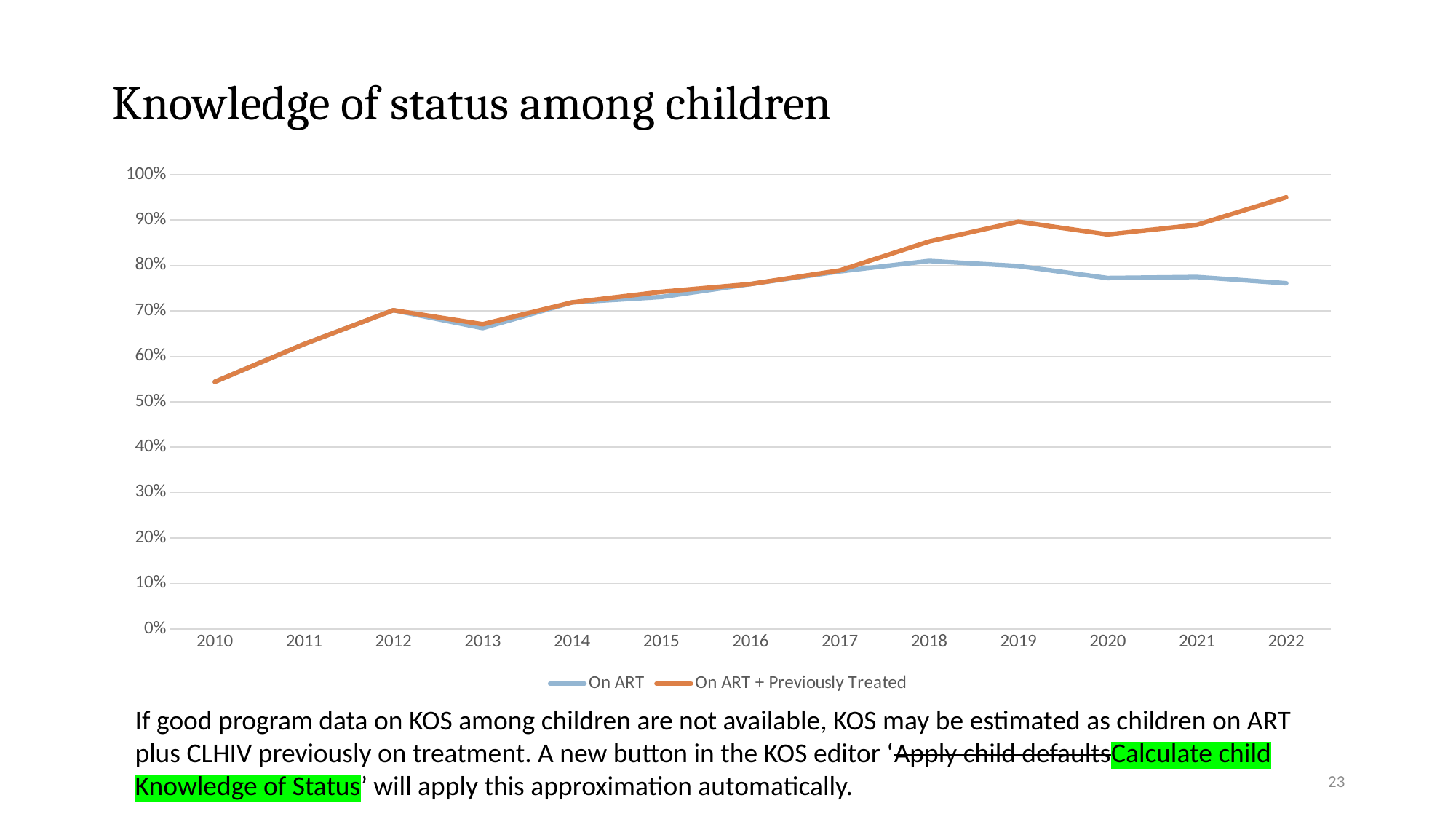
How many series does the legend list? 2 Is the value for On ART in 2010 greater or less than 60%? less In 2022, which series has the higher value, On ART or On ART + Previously Treated? On ART + Previously Treated In which year is the On ART + Previously Treated series at its highest? 2022 How many years are plotted along the x axis? 13 Is the value for On ART in 2022 greater or less than 80%? less What is the title of the slide containing the chart? Knowledge of status among children Is the value for On ART + Previously Treated in 2022 greater or less than 90%? greater Does the On ART series rise or fall between 2018 and 2022? fall In which year is the On ART series at its lowest? 2010 What kind of chart is shown on the slide? line chart